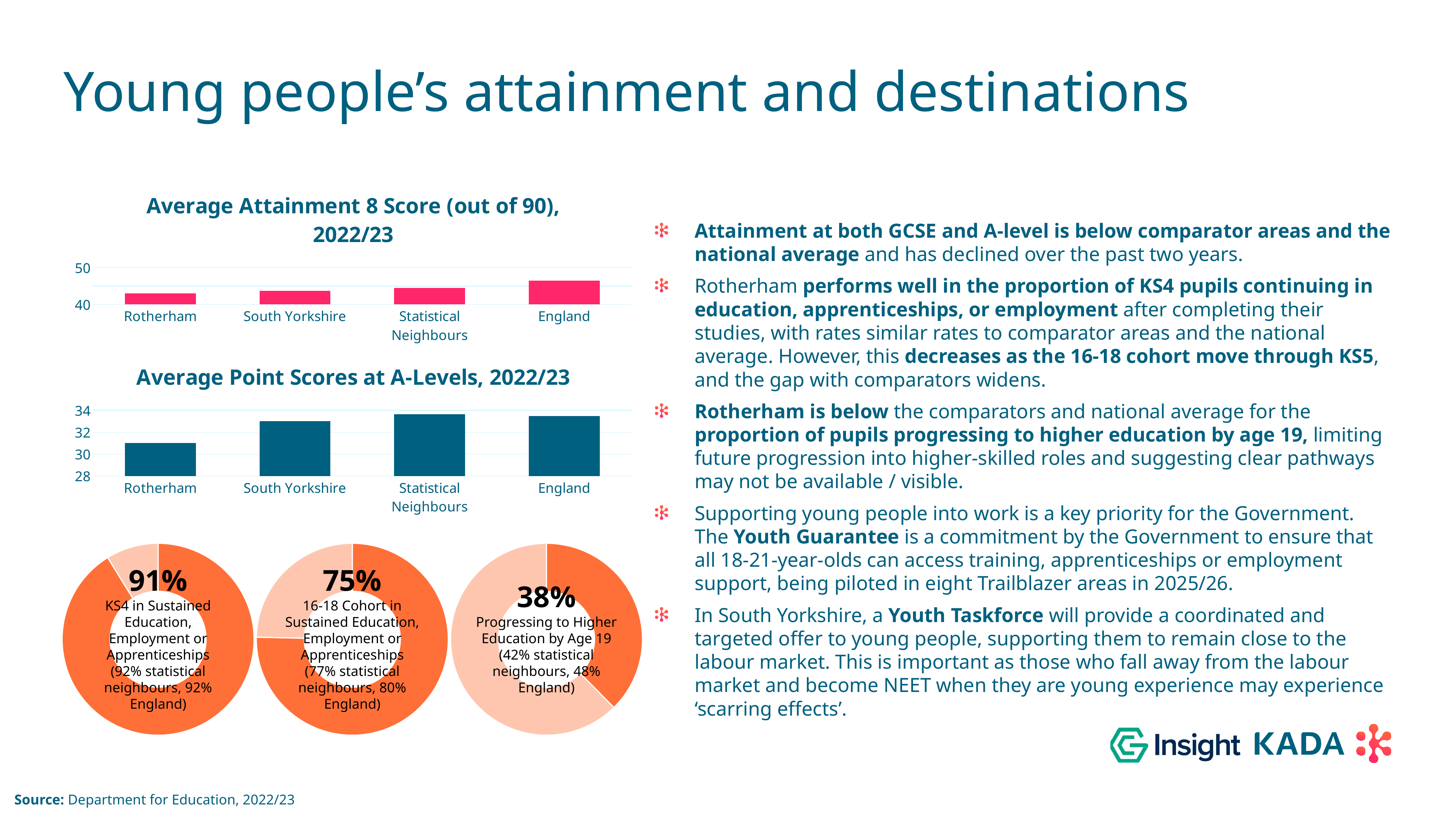
In the left donut chart, what share of KS4 pupils are in sustained education, employment or apprenticeships? 91% What kind of chart is the 'Average Attainment 8 Score (out of 90), 2022/23' chart? bar chart In the 'Average Point Scores at A-Levels, 2022/23' chart, is the value for South Yorkshire greater or less than 32? greater In the right donut chart, what share of pupils are progressing to higher education by age 19? 38% In the 'Average Attainment 8 Score (out of 90), 2022/23' chart, is the value for Rotherham greater or less than 40? greater In the 'Average Point Scores at A-Levels, 2022/23' chart, which is larger, the value for Rotherham or the value for Statistical Neighbours? Statistical Neighbours In the 'Average Point Scores at A-Levels, 2022/23' chart, which area has the lowest score? Rotherham In the 'Average Point Scores at A-Levels, 2022/23' chart, is the value for Rotherham greater or less than 32? less In the 'Average Attainment 8 Score (out of 90), 2022/23' chart, which is larger, the value for Rotherham or the value for England? England In the 'Average Attainment 8 Score (out of 90), 2022/23' chart, which area has the highest score? England How many areas are shown in the 'Average Point Scores at A-Levels, 2022/23' chart? 4